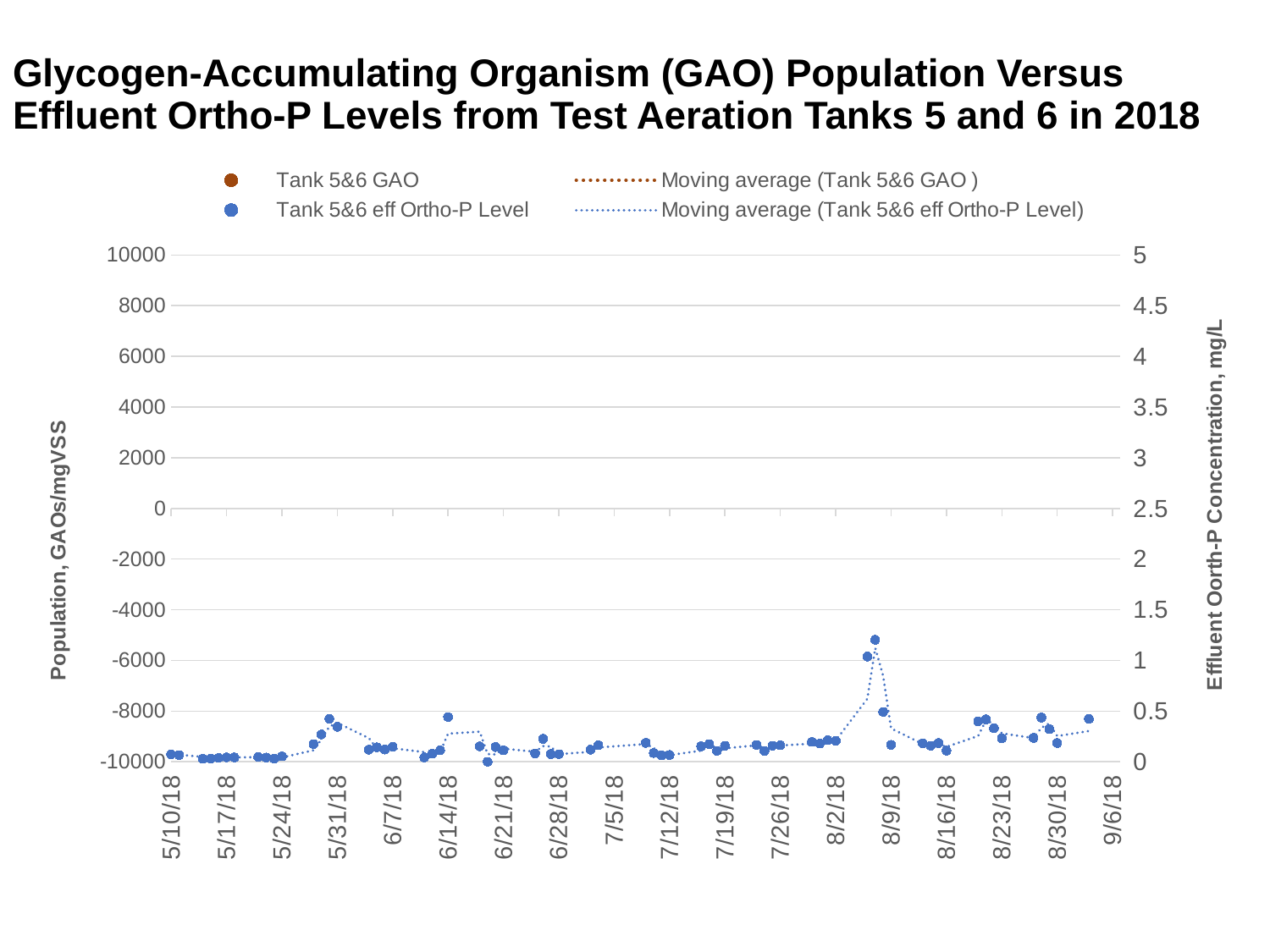
Is the Tank 5&6 eff Ortho-P Level value at 5/31/18 greater or less than 0.5 on the right axis? less What is the title of the chart? Glycogen-Accumulating Organism (GAO) Population Versus Effluent Ortho-P Levels from Test Aeration Tanks 5 and 6 in 2018 What kind of chart is shown on the slide? Scatter chart with moving average lines Is the Tank 5&6 eff Ortho-P Level value at 7/12/18 greater or less than 1 on the right axis? less What is the label of the right-hand vertical axis? Effluent Oorth-P Concentration, mg/L Is the Tank 5&6 eff Ortho-P Level value at 6/21/18 greater or less than 0.5 on the right axis? less Around which x-axis date does the Tank 5&6 eff Ortho-P Level reach its highest value? 8/9/18 How many date labels are shown on the x axis? 18 What is the maximum value shown on the right-hand vertical axis? 5 How many series does the legend list? 4 Which is larger: the Tank 5&6 eff Ortho-P Level near 8/9/18 or near 5/31/18? Near 8/9/18